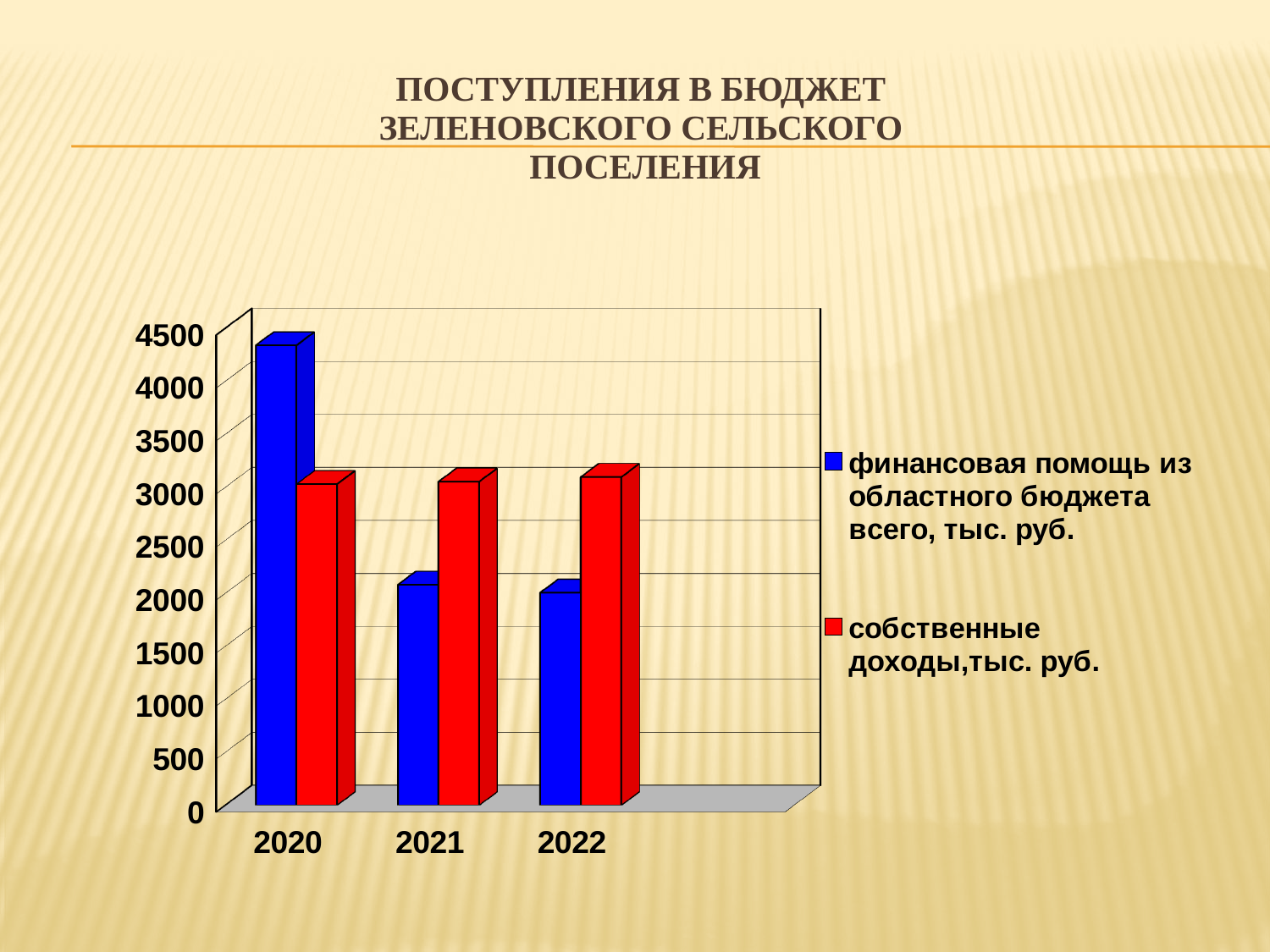
In which year is the value for "финансовая помощь из областного бюджета всего, тыс. руб." highest? 2020 In 2020, which is larger: "финансовая помощь из областного бюджета всего, тыс. руб." or "собственные доходы,тыс. руб."? финансовая помощь из областного бюджета всего, тыс. руб. How many years are shown on the x axis? 3 Is the value for "собственные доходы,тыс. руб." in 2021 greater or less than 3500? less Does the value for "финансовая помощь из областного бюджета всего, тыс. руб." rise or fall from 2020 to 2022? fall How many series does the legend list? 2 Is the value for "финансовая помощь из областного бюджета всего, тыс. руб." in 2020 greater or less than 4000? greater Is the value for "собственные доходы,тыс. руб." in 2022 greater or less than 2500? greater In 2022, which is larger: "финансовая помощь из областного бюджета всего, тыс. руб." or "собственные доходы,тыс. руб."? собственные доходы,тыс. руб. Which colour represents "собственные доходы,тыс. руб." in the chart? red What kind of chart is shown on the slide? bar chart